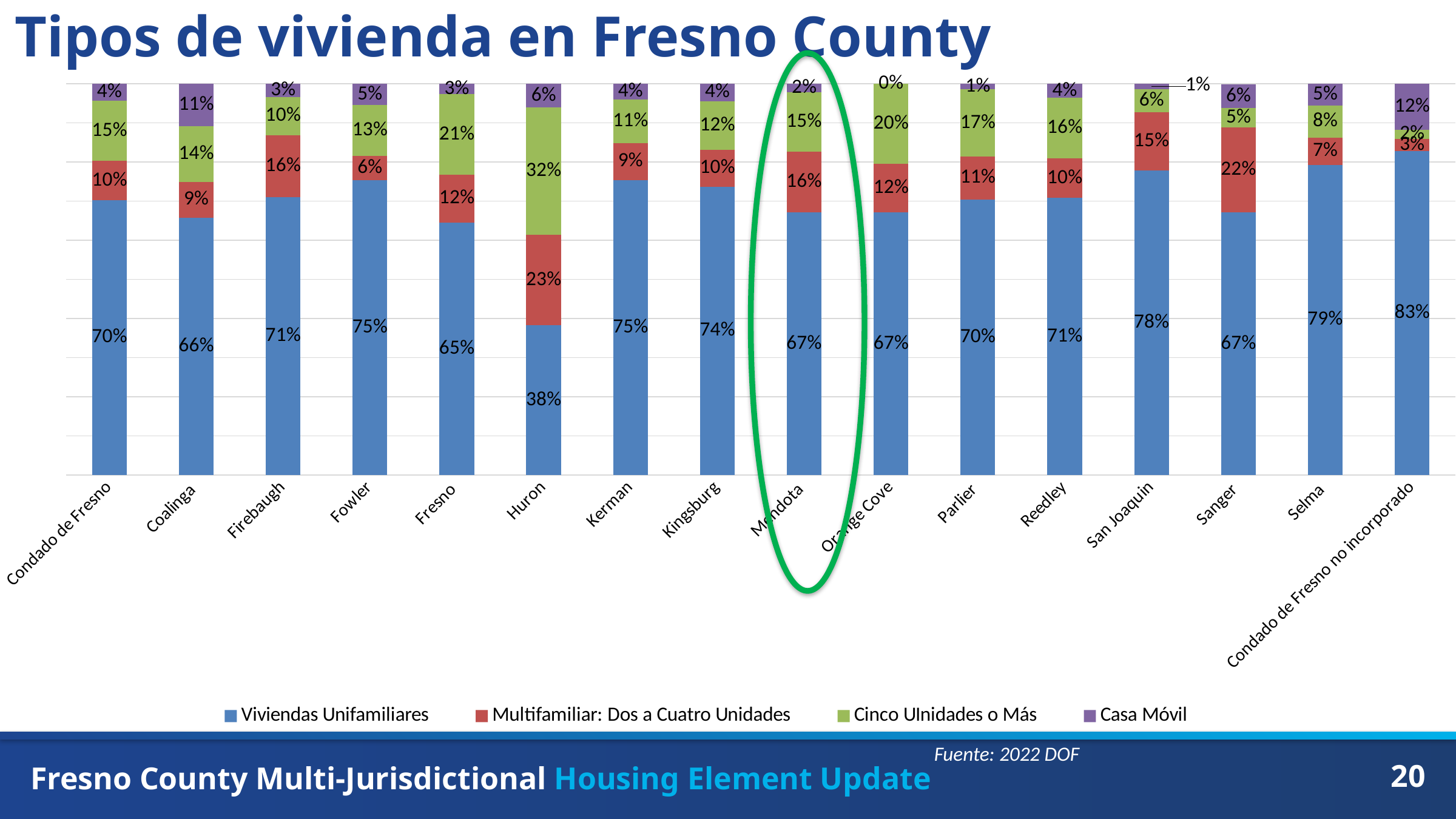
Which category has the highest Viviendas Unifamiliares share? Condado de Fresno no incorporado How many categories are shown on the x axis? 16 What is the Cinco UInidades o Más value for Orange Cove? 20% What is the difference between the Viviendas Unifamiliares share in Selma and in Fresno? 14% Which category has the lowest Viviendas Unifamiliares share? Huron What kind of chart is shown on the slide? Stacked bar chart How many series does the legend list? 4 Which has a larger Cinco UInidades o Más share, Huron or Fresno? Huron What is the Multifamiliar: Dos a Cuatro Unidades value for Sanger? 22% What percentage of housing in Huron is Viviendas Unifamiliares? 38% Which category on the chart is circled in green? Mendota What is the Casa Móvil share for Coalinga? 11%